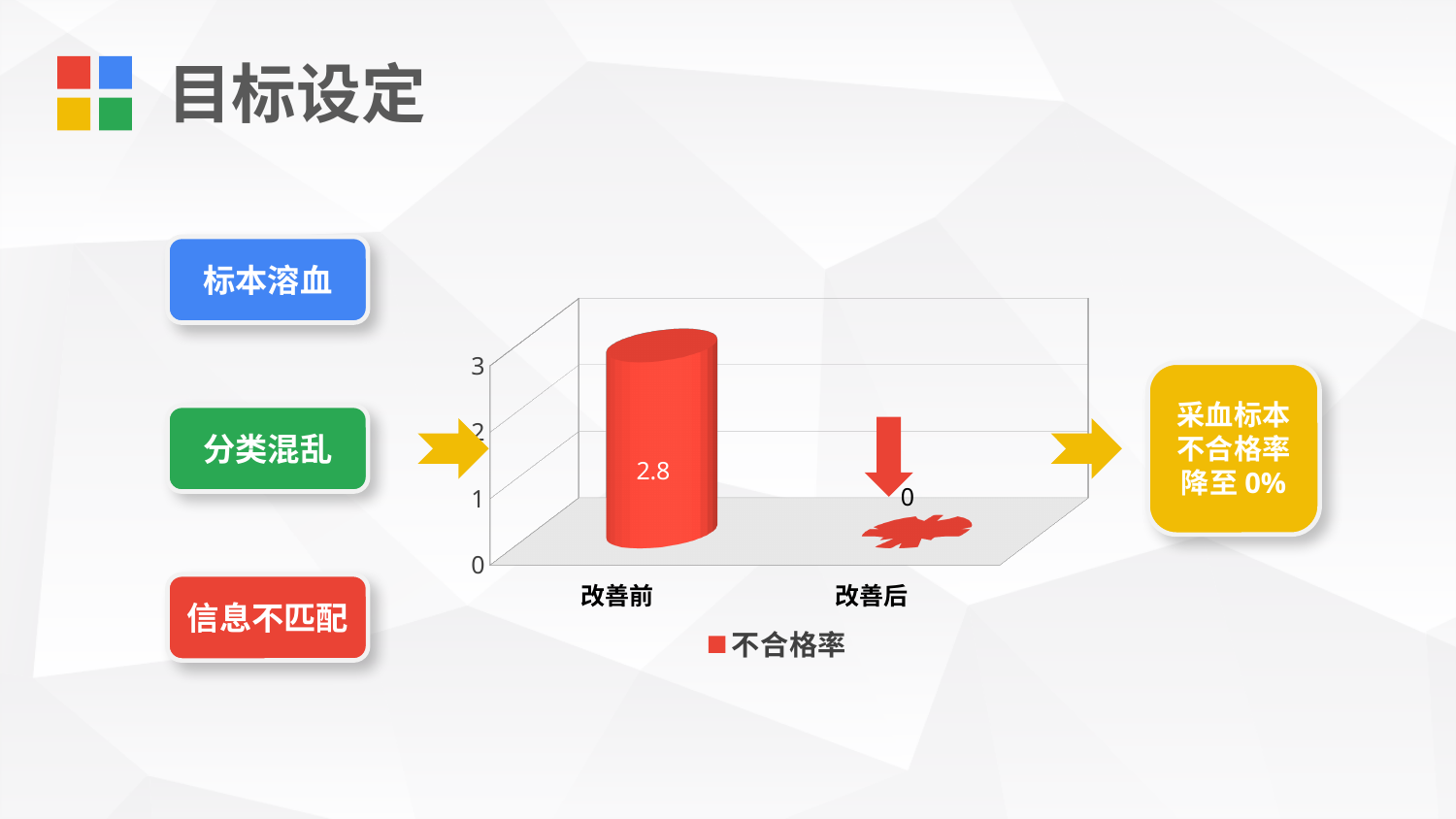
What series name is shown in the legend? 不合格率 What kind of chart is shown? bar chart Which is larger, the value for 改善前 or 改善后? 改善前 What is the difference between the values for 改善前 and 改善后? 2.8 What is the value for 改善后? 0 How many series does the legend list? 1 Do the values rise or fall from 改善前 to 改善后? fall Is the value for 改善前 greater or less than 2? greater How many categories are shown on the x axis? 2 Which category has the lowest value? 改善后 Which category has the highest value? 改善前 What is the value for 改善前? 2.8